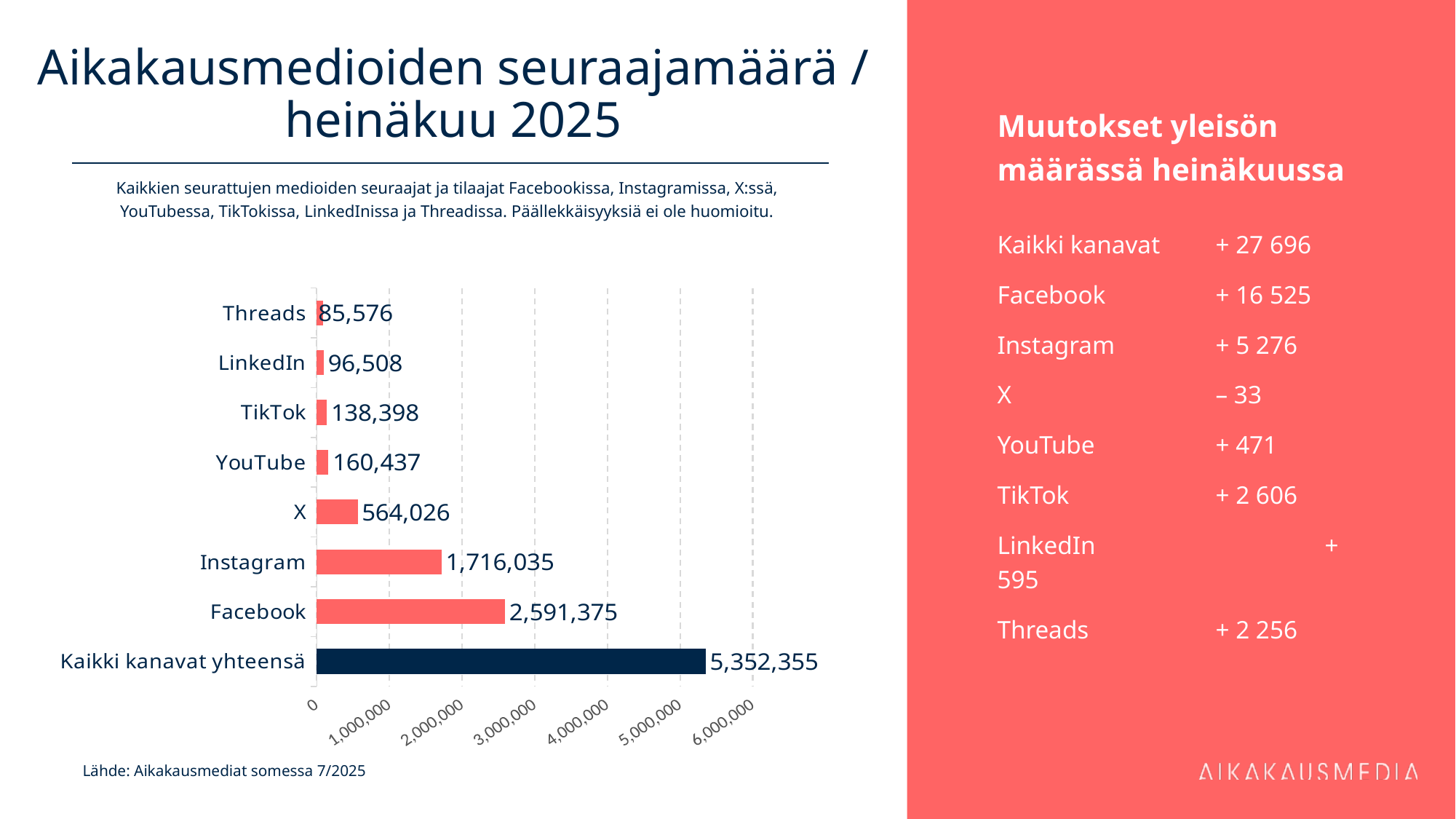
What kind of chart is shown on the slide? bar chart Is the value for X greater or less than 1,000,000? less What is the value for Facebook in the bar chart? 2,591,375 What is the value for Kaikki kanavat yhteensä in the bar chart? 5,352,355 What is the difference between the values for Facebook and Instagram? 875,340 How many categories are shown in the bar chart? 8 Which individual channel (excluding the total bar) has the highest value in the chart? Facebook What is the value for Instagram in the bar chart? 1,716,035 What is the value for Threads in the bar chart? 85,576 Which category has the lowest value in the chart? Threads Which is larger, the value for X or the value for YouTube? X What is the difference between the values for YouTube and TikTok? 22,039